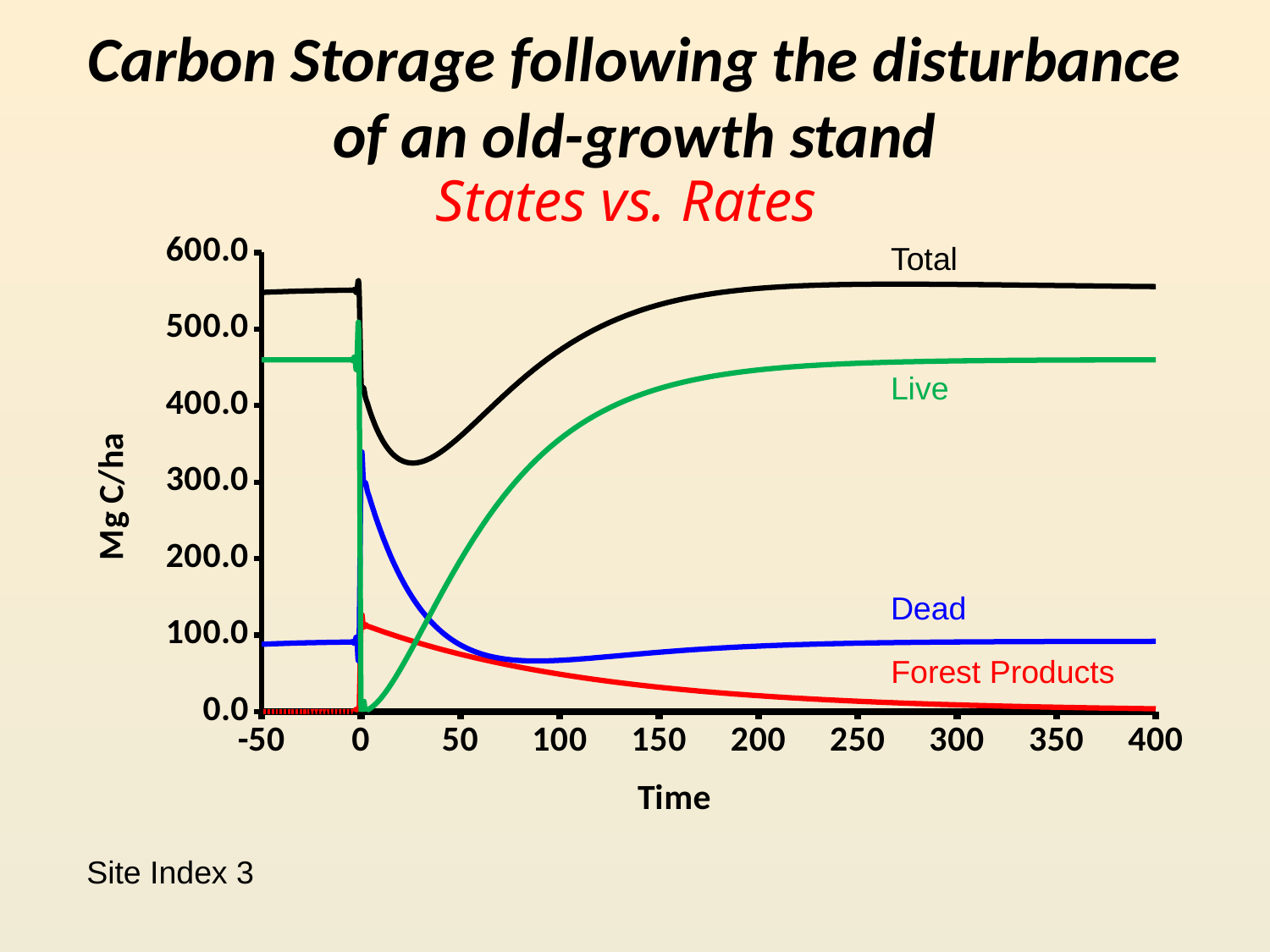
Is the value of the Total series at time 400 greater or less than 500? greater Is the value of the Live series at time 400 greater or less than 400? greater Is the value of the Forest Products series at time 400 greater or less than 100? less At time 200, which series is larger, Dead or Forest Products? Dead At time 100, which series is larger, Live or Dead? Live Which series has the highest value at time 400? Total What kind of chart is shown on the slide? line chart How many series are plotted on the chart? 4 Which series has the lowest value at time 400? Forest Products Does the Forest Products series rise or fall between time 0 and time 400? fall What is the label of the y axis? Mg C/ha